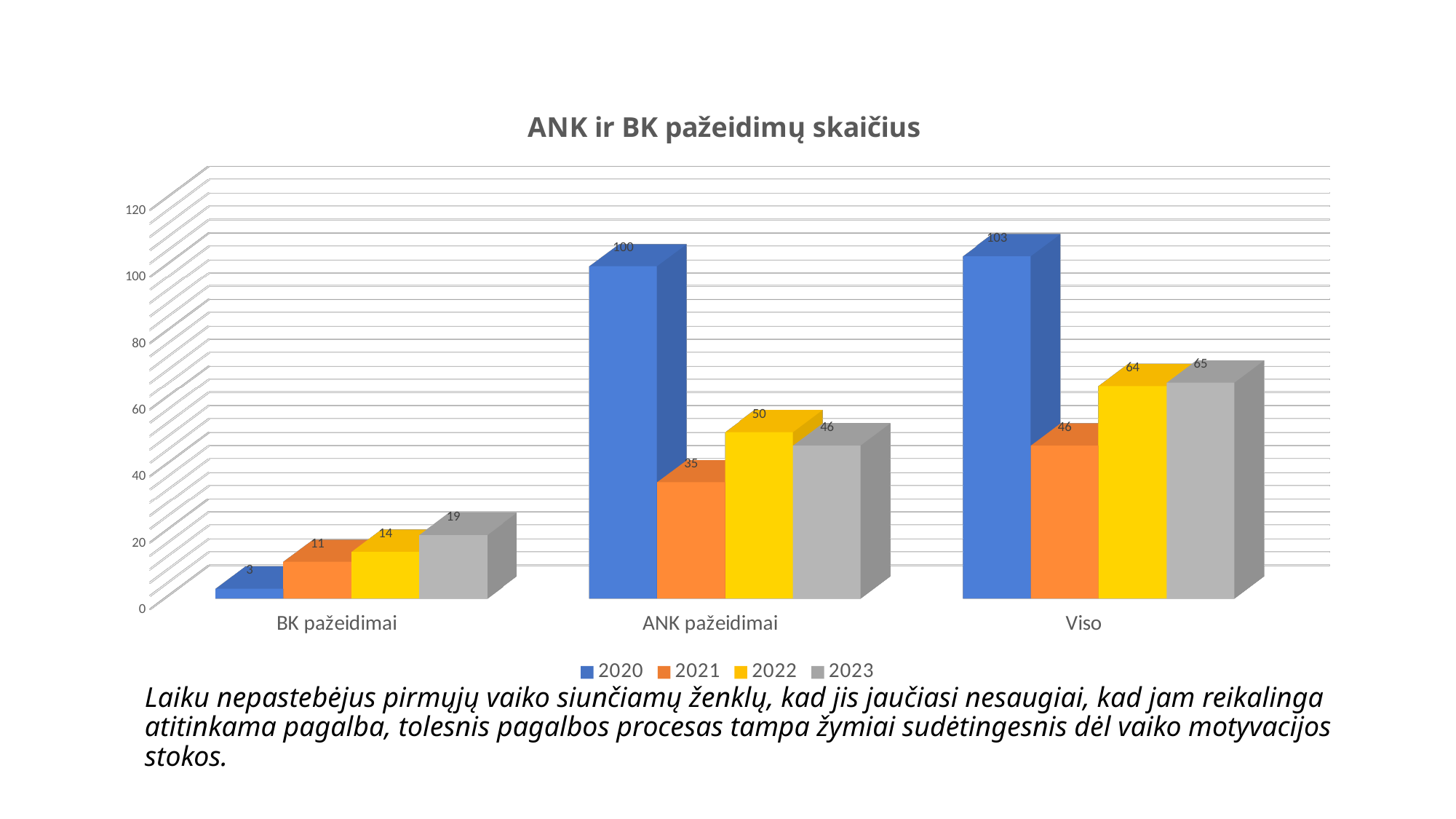
What is the value for 2023 in the BK pažeidimai category? 19 Which year has the highest value in the Viso category? 2020 How many categories are shown on the x axis? 3 Is the value for 2020 in the Viso category greater or less than 100? greater What is the value for 2020 in the ANK pažeidimai category? 100 Which is larger in the ANK pažeidimai category: the 2022 value or the 2023 value? 2022 What kind of chart is shown on the slide? bar chart What is the value for 2021 in the Viso category? 46 How many series does the legend list? 4 Which year has the lowest value in the BK pažeidimai category? 2020 What is the title of the chart? ANK ir BK pažeidimų skaičius What is the difference between the 2020 and 2021 values in the ANK pažeidimai category? 65